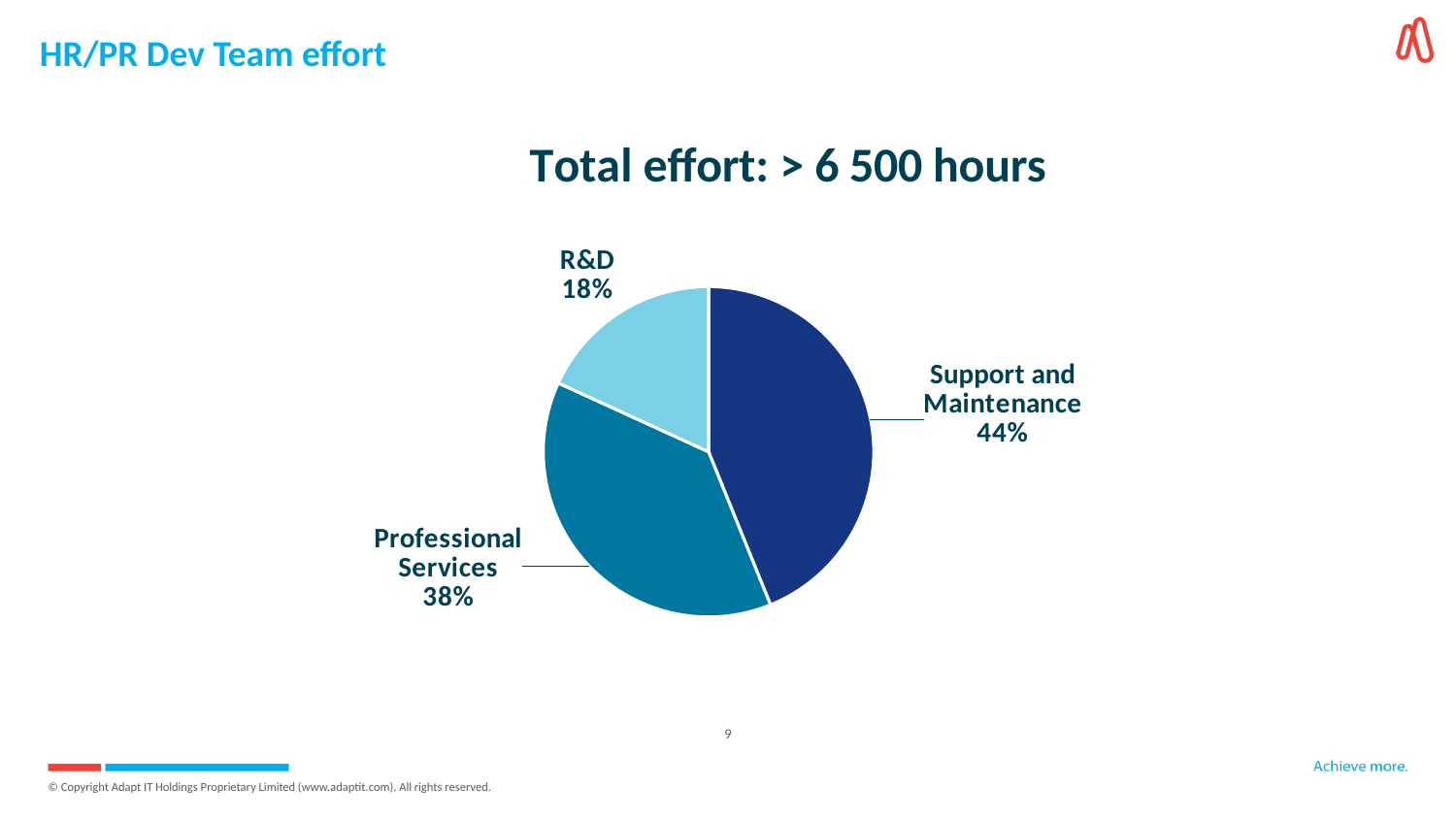
Which is larger, the share for Professional Services or the share for R&D? Professional Services What share of the total effort is Professional Services? 38% Which category has the largest share of the pie? Support and Maintenance What is the difference in percentage points between Professional Services and R&D? 20 What share of the total effort is R&D? 18% What share of the total effort is Support and Maintenance? 44% Which category has the smallest share of the pie? R&D What kind of chart is shown on the slide? Pie chart How many slices does the pie chart have? 3 What is the difference in percentage points between Support and Maintenance and Professional Services? 6 What is the combined share of Support and Maintenance and R&D? 62% What is the title shown above the chart? Total effort: > 6 500 hours